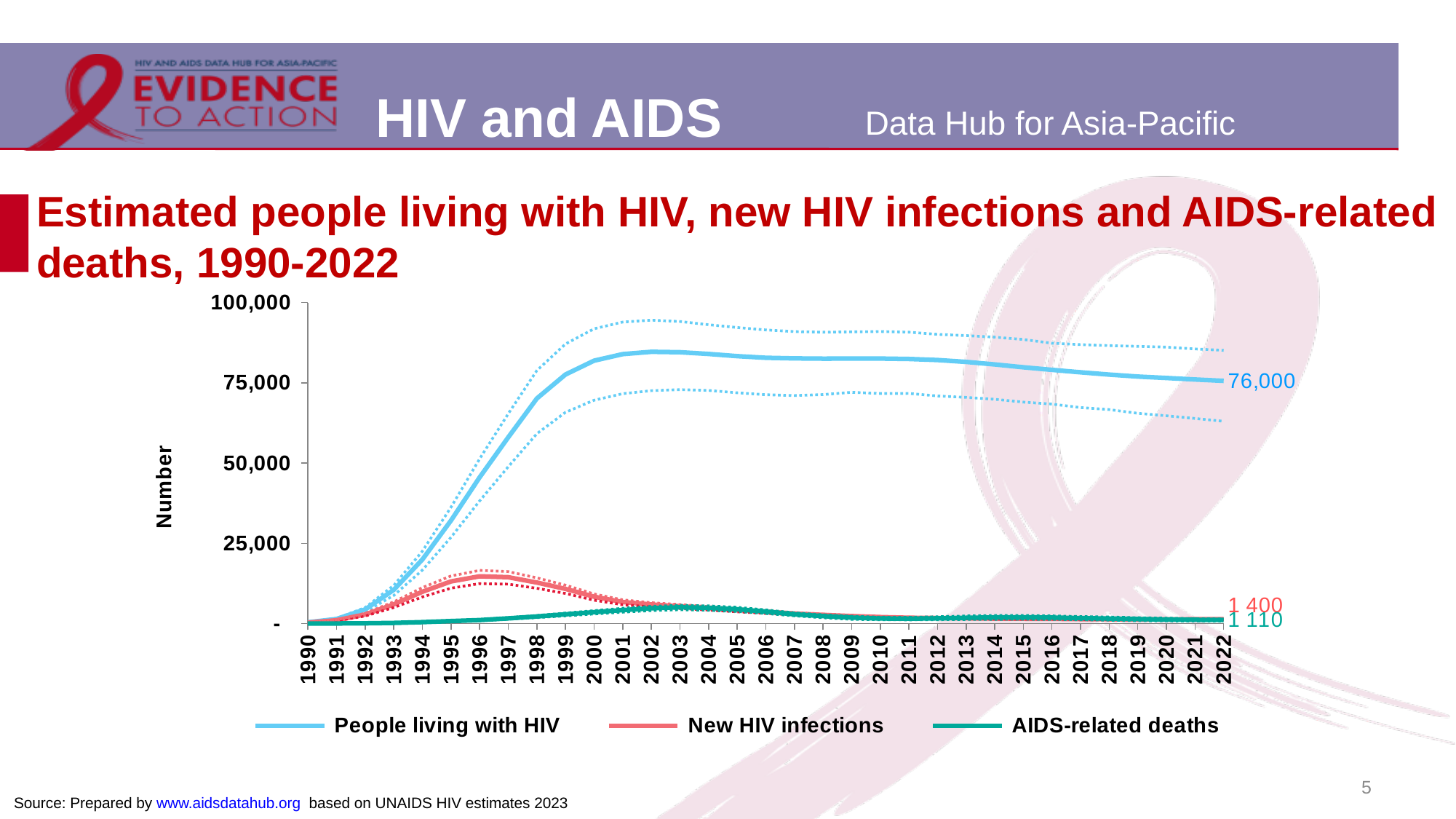
How many series does the legend list? 3 In 2022, which is larger: New HIV infections or AIDS-related deaths? New HIV infections Which series has the highest value in 2022? People living with HIV What is the value for AIDS-related deaths in 2022? 1 110 What is the difference between New HIV infections and AIDS-related deaths in 2022? 290 Is the value for People living with HIV in 1995 greater or less than 50,000? less What is the value for New HIV infections in 2022? 1 400 What is the value for People living with HIV in 2022? 76,000 What kind of chart is shown on the slide? line chart Does the People living with HIV line rise or fall between 2010 and 2022? fall Is the value for People living with HIV in 2000 greater or less than 75,000? greater Is the peak value for New HIV infections greater or less than 25,000? less